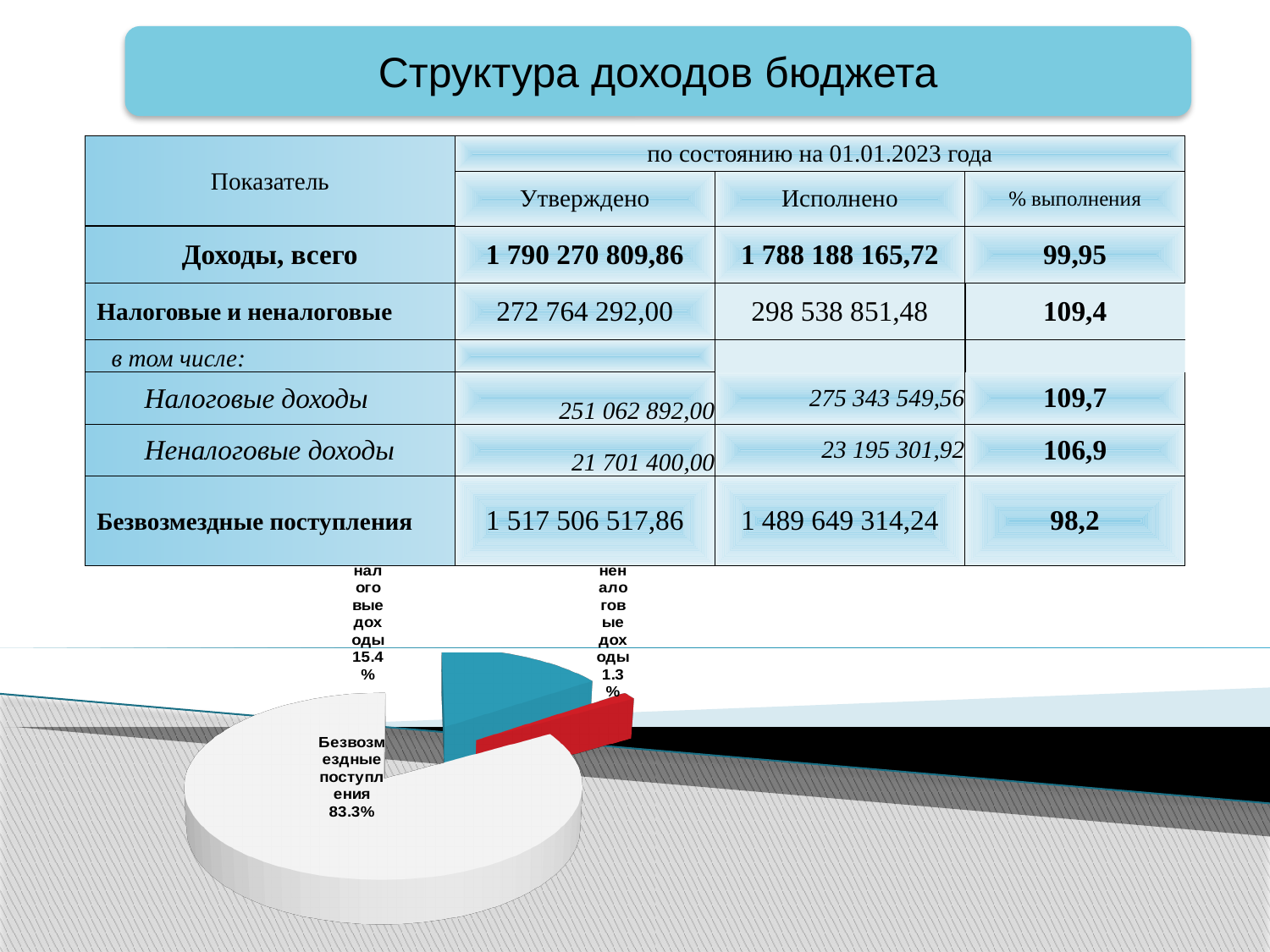
What colour is the slice for Безвозмездные поступления in the pie chart? white Which slice of the pie chart is the smallest? неналоговые доходы Which slice of the pie chart is the largest? Безвозмездные поступления In the pie chart, what is the difference in percentage points between налоговые доходы and неналоговые доходы? 14.1 What kind of chart is shown at the bottom of the slide? pie chart In the pie chart, which is larger: налоговые доходы or неналоговые доходы? налоговые доходы What share of the pie chart is labelled "Безвозмездные поступления"? 83.3% What share of the pie chart is labelled "налоговые доходы"? 15.4% What colour is the slice for неналоговые доходы in the pie chart? red How many slices does the pie chart have? 3 What share of the pie chart is labelled "неналоговые доходы"? 1.3% In the pie chart, what is the difference in percentage points between Безвозмездные поступления and налоговые доходы? 67.9